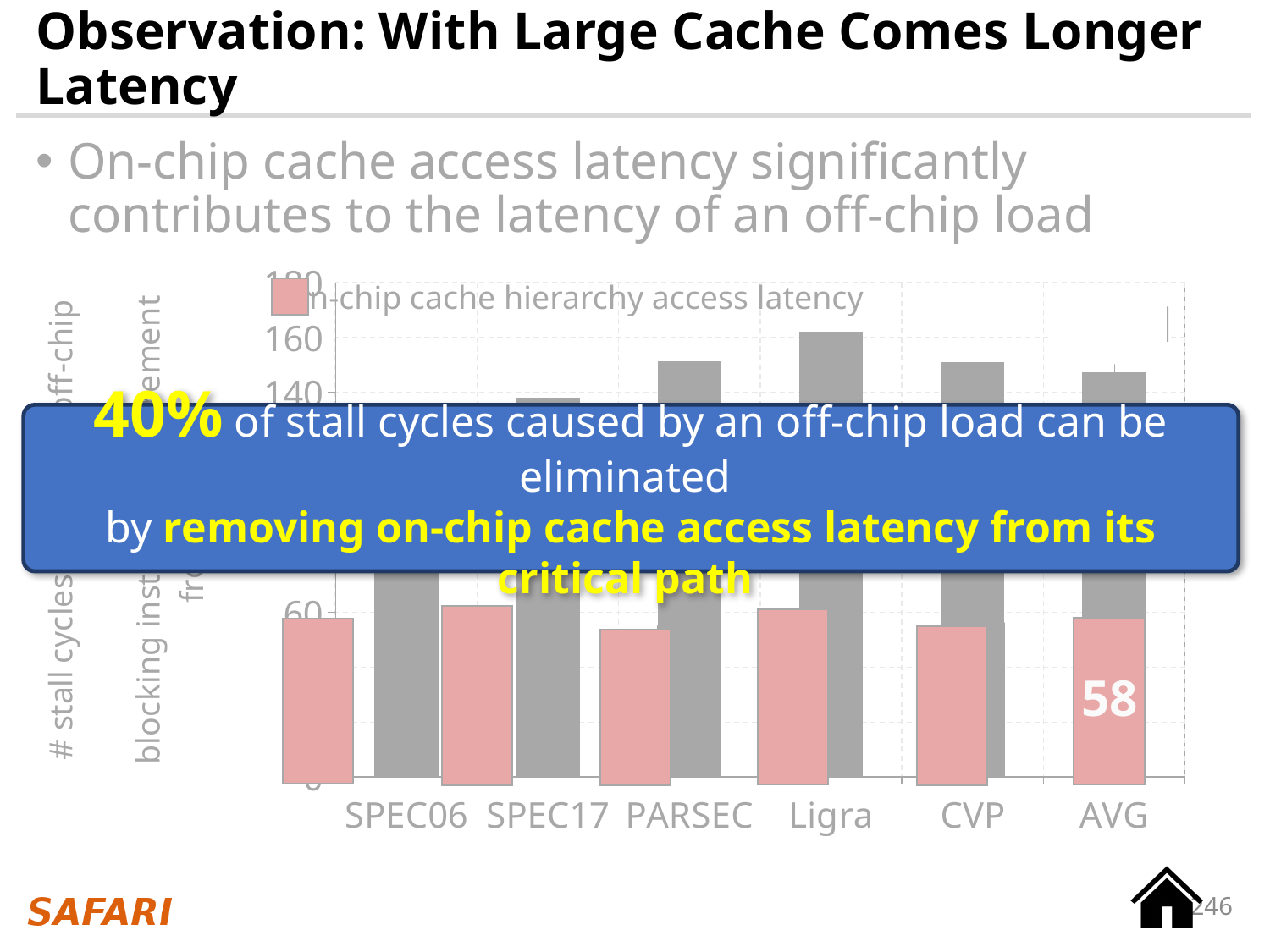
What type of chart is shown on the slide? bar chart How many categories are shown on the x axis of the chart? 6 Is the on-chip cache hierarchy access latency bar for PARSEC greater or less than 60? less Is the gray bar for Ligra greater or less than 140? greater What is the label of the last category on the x axis? AVG What is the labelled value of the on-chip cache hierarchy access latency bar for AVG? 58 For AVG, which bar is taller, the gray bar or the on-chip cache hierarchy access latency bar? the gray bar Is the on-chip cache hierarchy access latency bar for CVP greater or less than 60? less Which is larger, the on-chip cache hierarchy access latency bar for SPEC17 or for PARSEC? SPEC17 Which is larger, the gray bar for Ligra or the gray bar for PARSEC? Ligra What colour are the bars for on-chip cache hierarchy access latency? pink Which category has the tallest gray bar? Ligra